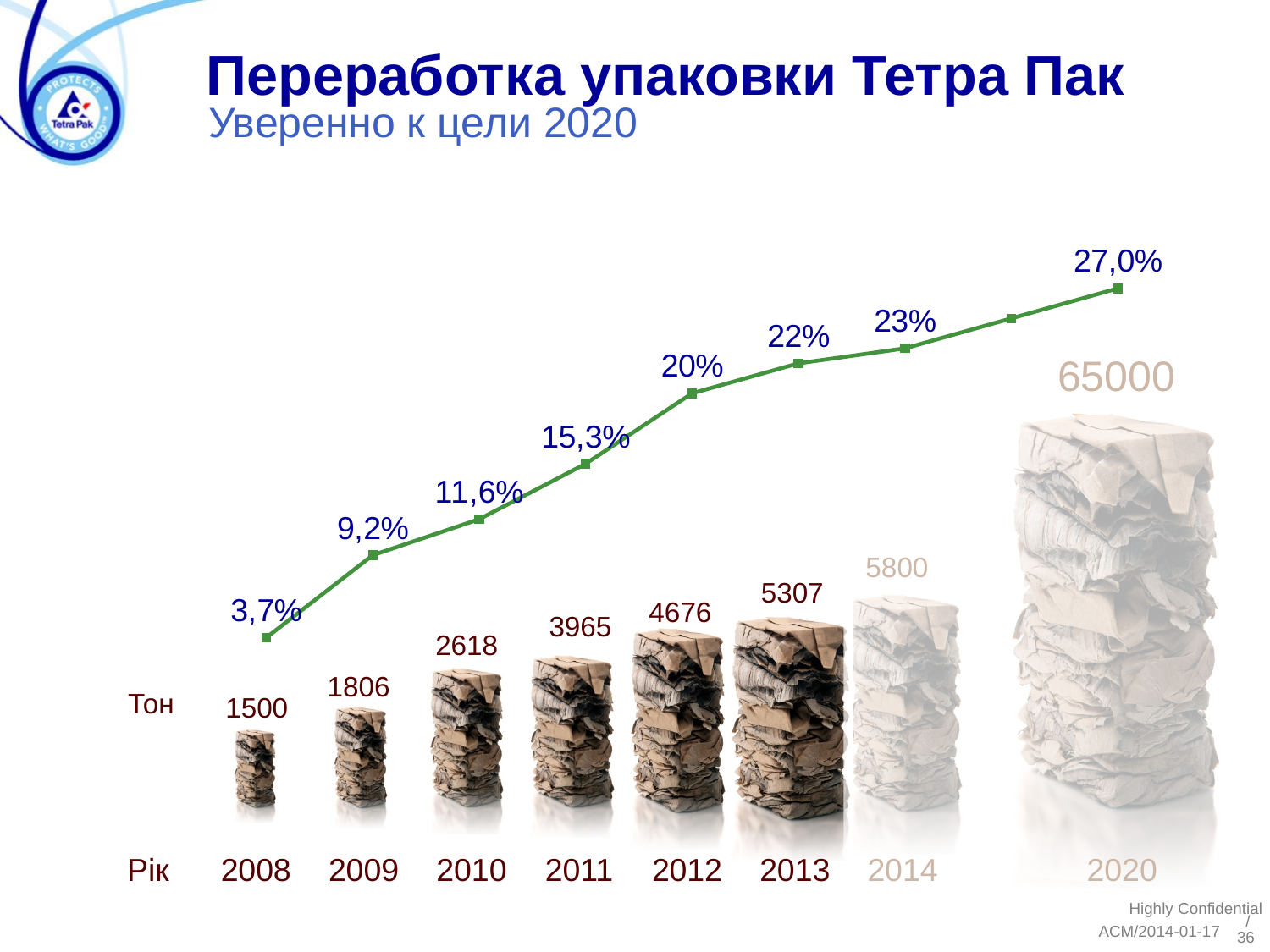
How many years are labeled on the x axis? 8 Which year has the lowest tonnage shown? 2008 Which year has the larger tonnage, 2010 or 2011? 2011 What is the difference in tons between 2009 and 2008? 306 What tonnage is shown for the 2020 target? 65000 Does the percentage line rise or fall from 2008 to 2020? rise Which year has the highest percentage on the line? 2020 What is the title of the chart slide? Переработка упаковки Тетра Пак What is the difference in tons between 2013 and 2012? 631 How many tons are shown for 2011? 3965 What is the recycling percentage shown for 2012? 20% What is the percentage value shown for 2008? 3,7%